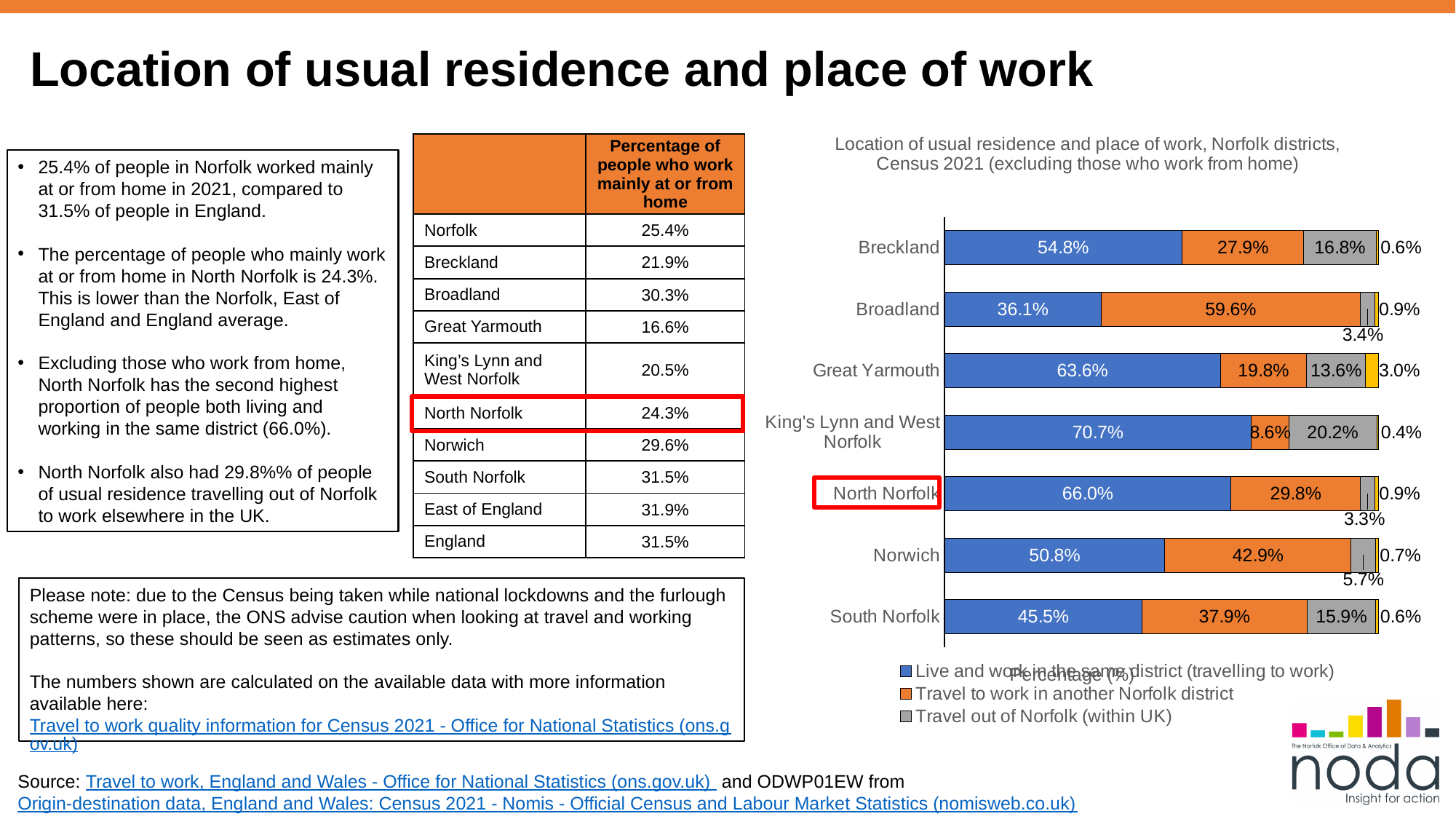
What percentage of Great Yarmouth residents travel out of Norfolk (within UK) to work? 13.6% Which district has the highest percentage of people travelling out of Norfolk (within UK) to work? King's Lynn and West Norfolk What percentage of Broadland residents travel to work in another Norfolk district? 59.6% Which district has the highest percentage of people who live and work in the same district? King's Lynn and West Norfolk What percentage of Breckland residents live and work in the same district (travelling to work)? 54.8% How many districts are plotted in the chart? 7 Which has a larger percentage of people travelling to work in another Norfolk district, Norwich or South Norfolk? Norwich What kind of chart is shown on the slide? Bar chart What is the difference between the percentage of people who live and work in the same district in North Norfolk and in Norwich? 15.2 percentage points What is the title of the chart? Location of usual residence and place of work, Norfolk districts, Census 2021 (excluding those who work from home) How many series does the chart's legend list? 3 Which district has the lowest percentage of people who live and work in the same district? Broadland